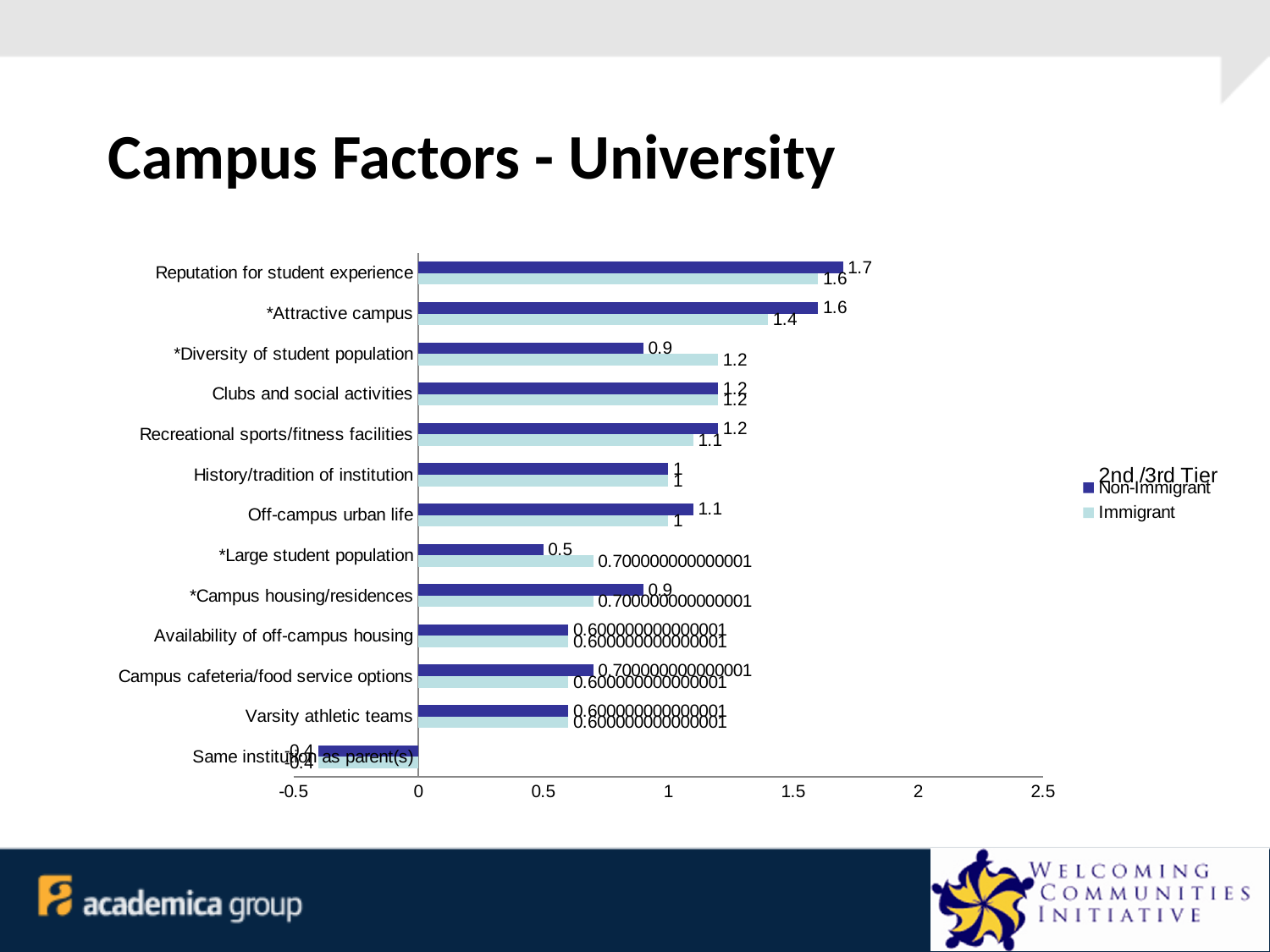
What is the difference between the Non-Immigrant and Immigrant values for *Attractive campus? 0.2 What is the Non-Immigrant value for Reputation for student experience? 1.7 What is the Immigrant value for *Attractive campus? 1.4 What kind of chart is shown on the slide? bar chart What is the Non-Immigrant value for *Large student population? 0.5 How many series does the legend list? 2 For *Diversity of student population, which series has the larger value, Non-Immigrant or Immigrant? Immigrant Which category has the highest Non-Immigrant value? Reputation for student experience How many categories are shown on the chart? 13 What is the Immigrant value for *Diversity of student population? 1.2 Is the Non-Immigrant value for Off-campus urban life greater or less than 1? greater Which category has the lowest Immigrant value? Same institution as parent(s)